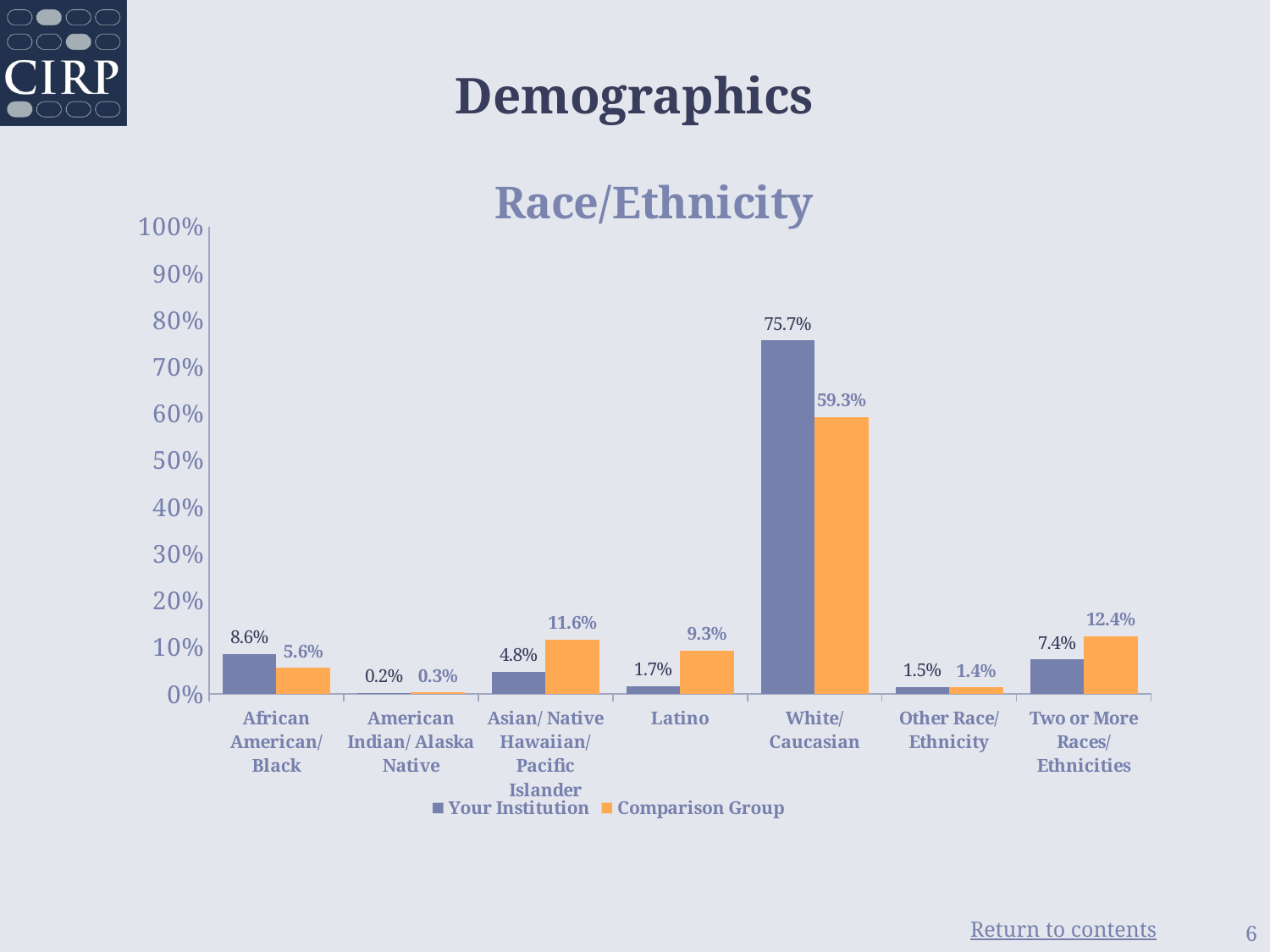
How many series does the legend list? 2 What is the Your Institution value for Latino? 1.7% What is the Comparison Group value for Asian/Native Hawaiian/Pacific Islander? 11.6% What kind of chart is shown on the slide? Bar chart Is the Comparison Group value for White/Caucasian greater or less than 50%? greater What is the Your Institution value for White/Caucasian? 75.7% Which is larger for African American/Black: Your Institution or Comparison Group? Your Institution Which category has the lowest Your Institution value? American Indian/Alaska Native How many race/ethnicity categories are shown on the x axis? 7 Which category has the highest Comparison Group value? White/Caucasian What is the Comparison Group value for Two or More Races/Ethnicities? 12.4% What is the difference between the Your Institution and Comparison Group values for White/Caucasian? 16.4%